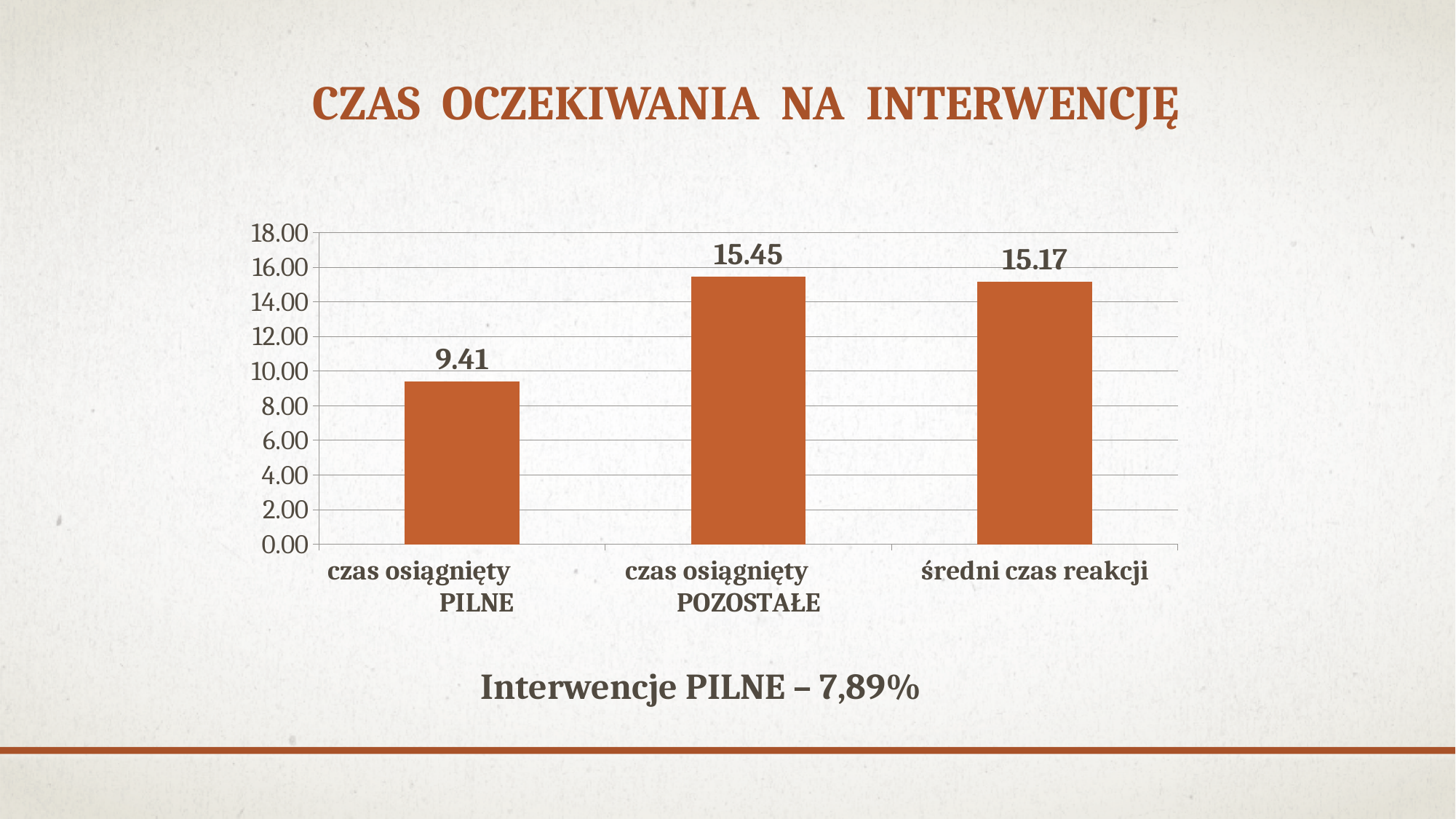
What is the difference between the values for "czas osiągnięty POZOSTAŁE" and "czas osiągnięty PILNE"? 6.04 What is the value for "czas osiągnięty POZOSTAŁE"? 15.45 How many categories are shown in the chart? 3 Which category has the lowest value? czas osiągnięty PILNE Which is larger: the value for "czas osiągnięty PILNE" or the value for "średni czas reakcji"? średni czas reakcji What is the title of the slide containing the chart? CZAS OCZEKIWANIA NA INTERWENCJĘ What is the value for "średni czas reakcji"? 15.17 Is the value for "czas osiągnięty PILNE" greater or less than 10.00? less What is the value for "czas osiągnięty PILNE"? 9.41 What is the difference between the values for "czas osiągnięty POZOSTAŁE" and "średni czas reakcji"? 0.28 Which category has the highest value? czas osiągnięty POZOSTAŁE What kind of chart is shown on the slide? bar chart